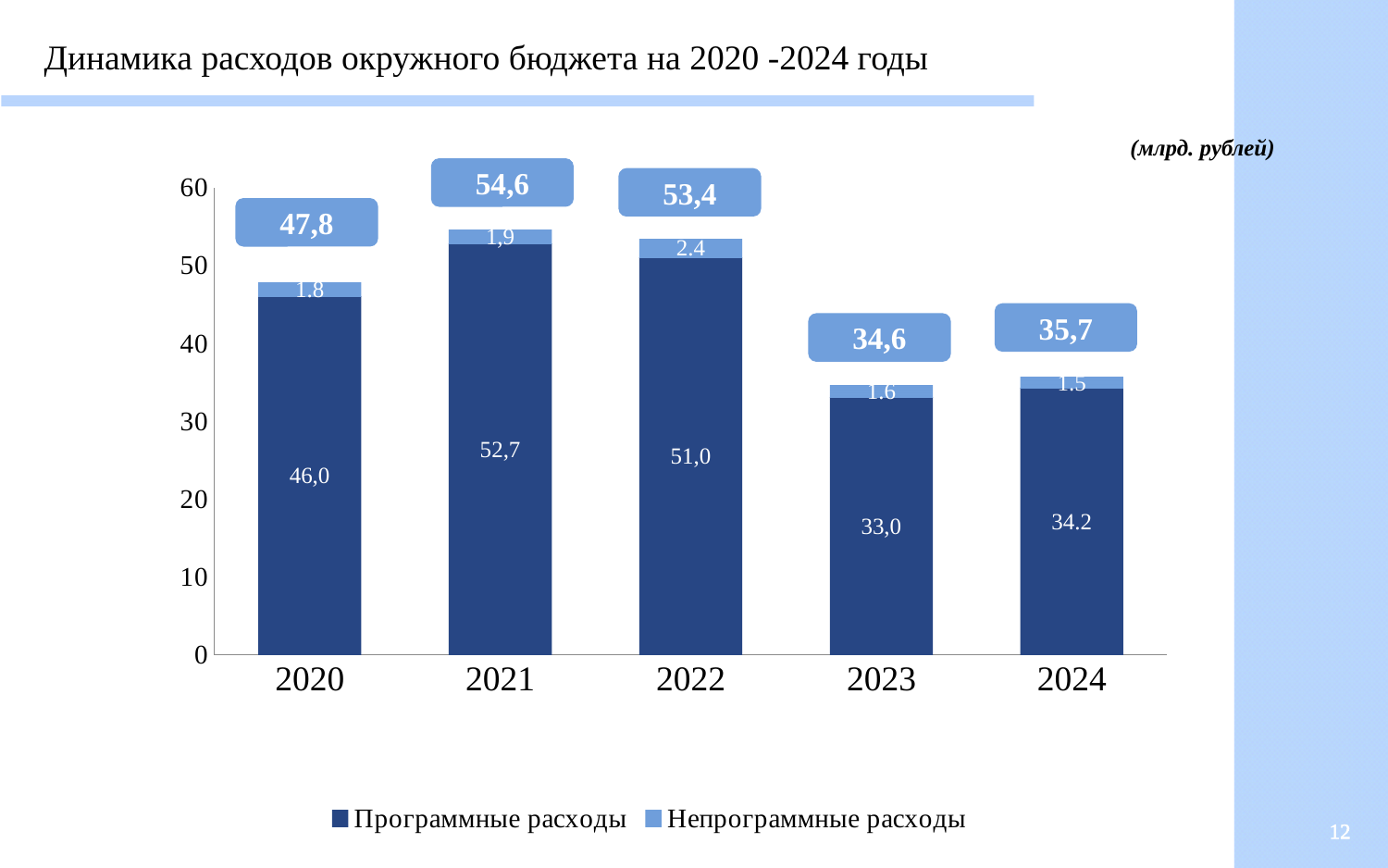
What is the value of Программные расходы for 2021? 52,7 What type of chart is shown on the slide? stacked bar chart What is the value of Программные расходы for 2024? 34.2 What unit is indicated for the values on the chart? млрд. рублей What is the total expenditure shown above the bar for 2023? 34,6 How many series does the legend list? 2 Which is larger: Программные расходы in 2020 or in 2022? 2022 Which year has the highest total expenditure? 2021 How many years are shown on the x axis? 5 What is the value of Непрограммные расходы for 2022? 2.4 What is the difference between the total expenditure in 2021 and in 2023? 20,0 Which year has the lowest total expenditure? 2023